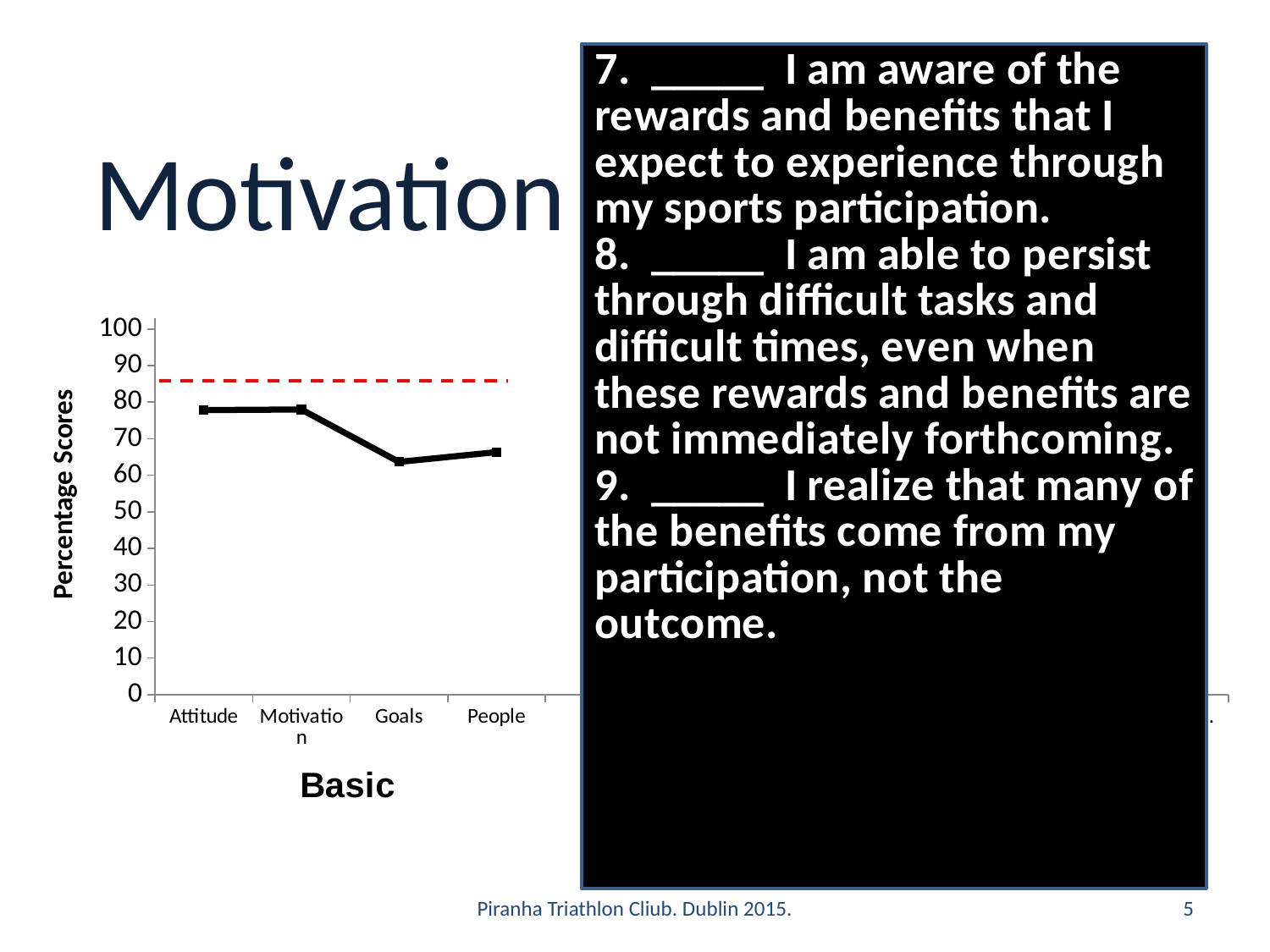
What is the label shown beneath the horizontal axis of the chart? Basic Is the value for Motivation greater or less than 90? less Is the value for Goals greater or less than 60? greater Does the line rise or fall from Motivation to Goals? fall Is the value for Attitude greater or less than 70? greater Which has the larger value, Attitude or Goals? Attitude What is the label on the vertical axis of the chart? Percentage Scores What kind of chart is shown on the slide? line chart Which has the larger value, Motivation or People? Motivation